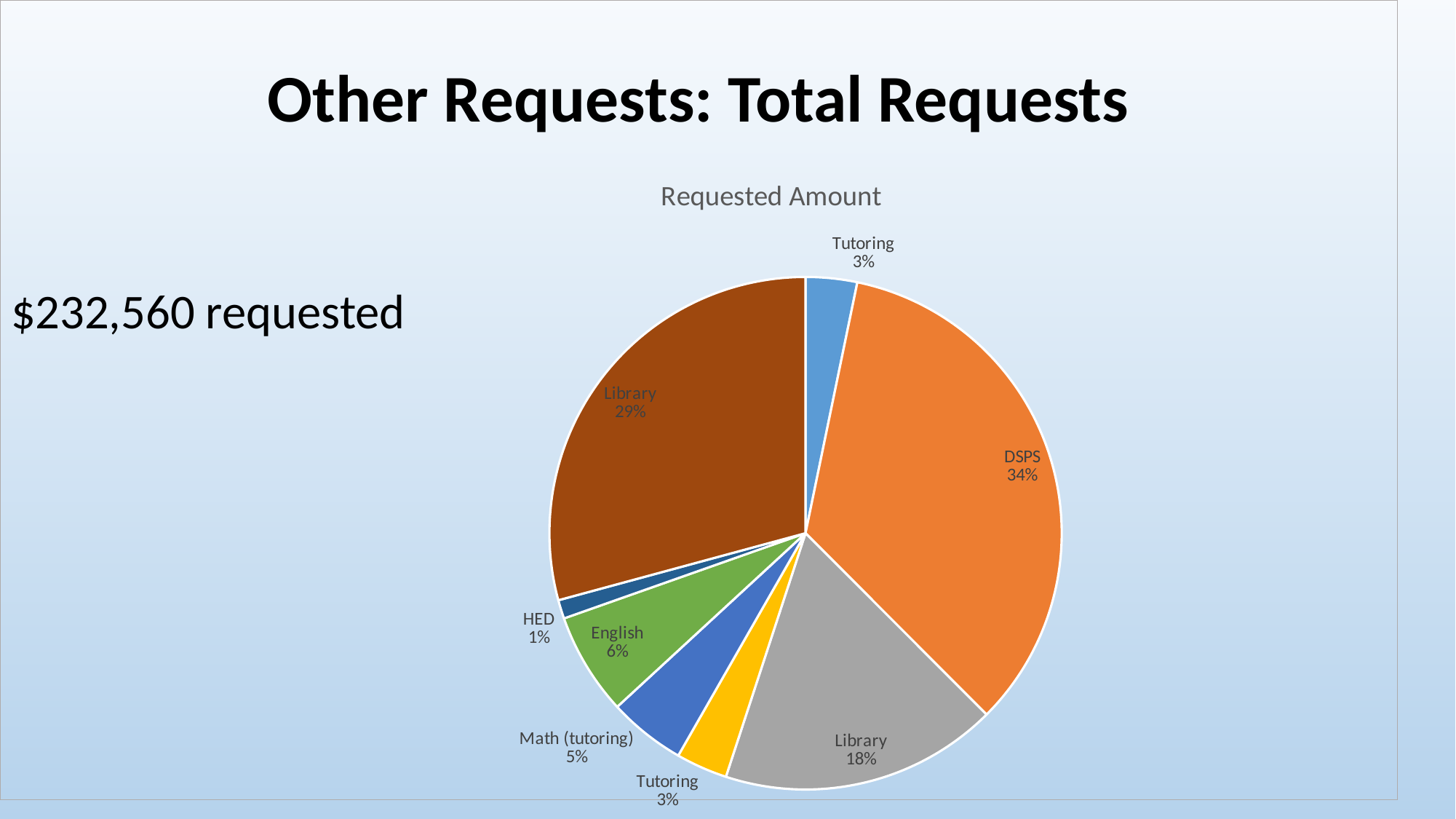
What is the difference in percentage points between DSPS and English? 28 What percentage is shown for the brown Library slice? 29% What kind of chart is shown on the slide? pie chart What percentage is shown for HED? 1% What percentage is shown for English? 6% What percentage is shown for the gray Library slice? 18% Which slice is the smallest in the pie chart? HED What percentage is shown for Math (tutoring)? 5% What is the title of the chart? Requested Amount What share of the pie does DSPS account for? 34% Which slice is the largest in the pie chart? DSPS How many slices does the pie chart have? 8